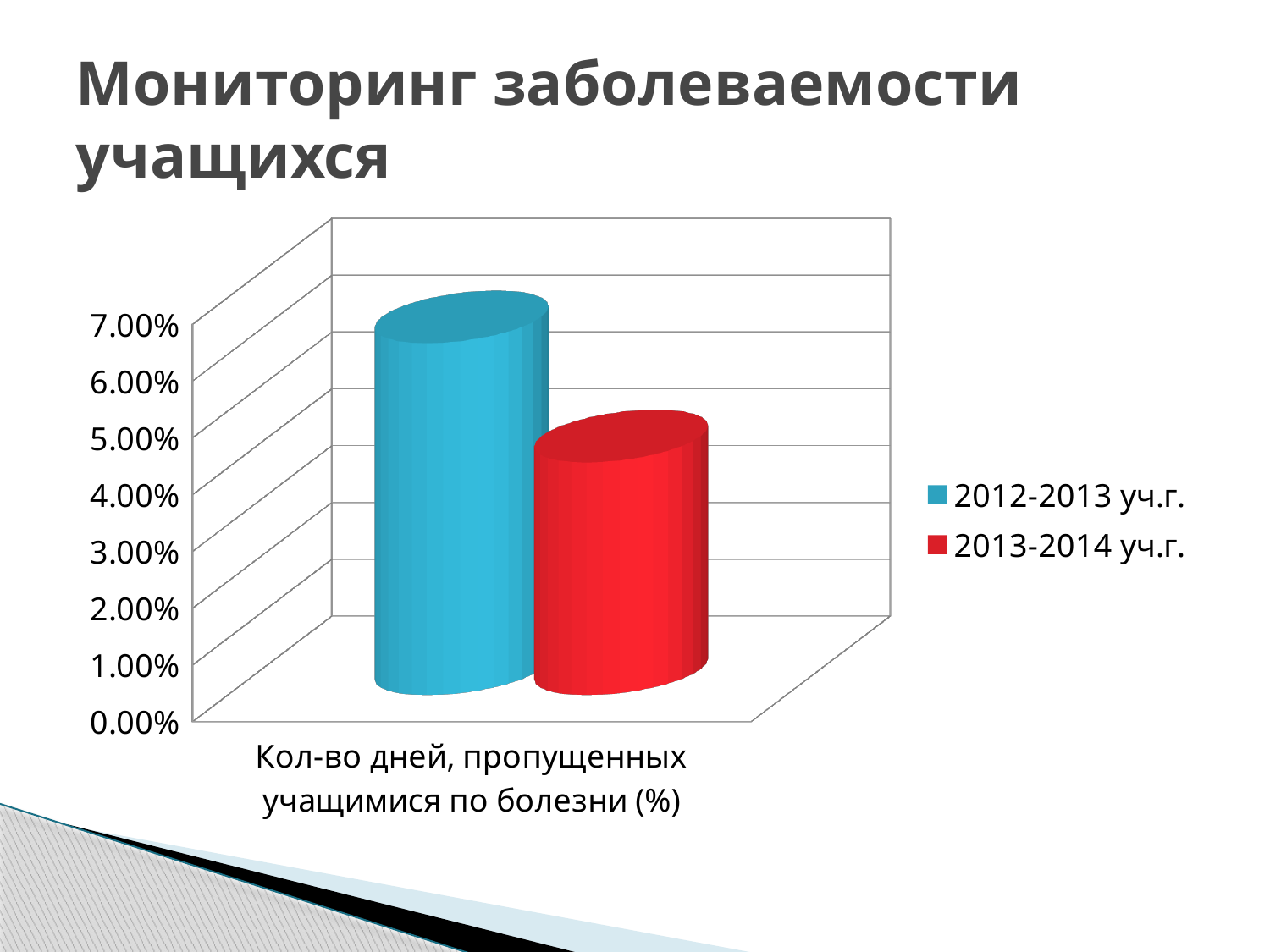
How many series does the legend list? 2 Is the value for 2013-2014 уч.г. greater or less than 7.00%? less Which series has the higher value: 2012-2013 уч.г. or 2013-2014 уч.г.? 2012-2013 уч.г. What colour represents the 2013-2014 уч.г. series? red What is the title of the slide? Мониторинг заболеваемости учащихся Which series has the highest value? 2012-2013 уч.г. Did the share of days missed due to illness rise or fall from 2012-2013 уч.г. to 2013-2014 уч.г.? fall What kind of chart is shown on the slide? bar chart Which series has the lowest value? 2013-2014 уч.г. How many categories are shown on the x axis? 1 Is the value for 2013-2014 уч.г. greater or less than 3.00%? greater Is the value for 2012-2013 уч.г. greater or less than 5.00%? greater